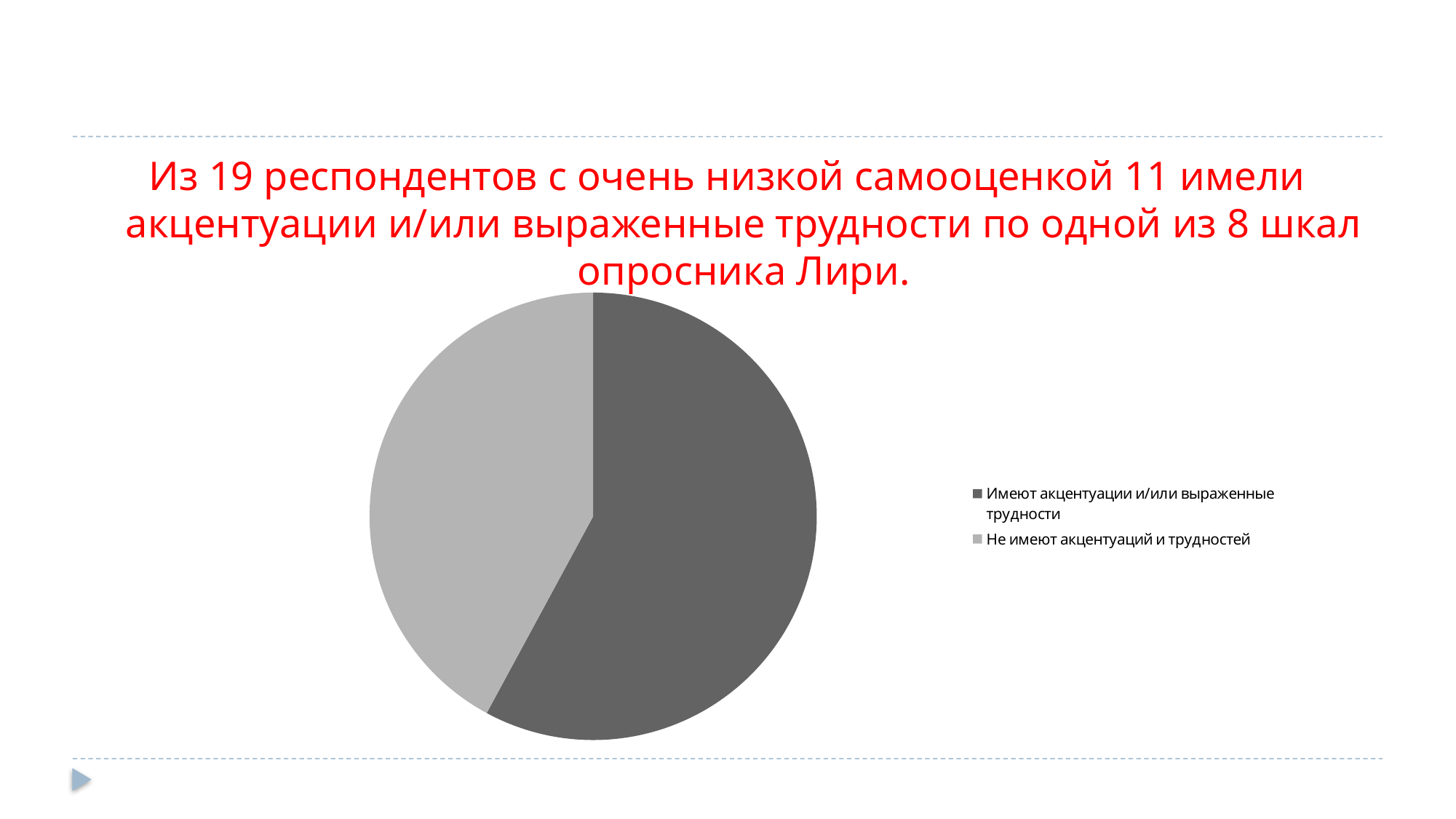
How many slices does the pie chart have? 2 Which slice is the smallest in the pie chart? Не имеют акцентуаций и трудностей Which legend entry is shown in the darker grey colour? Имеют акцентуации и/или выраженные трудности Which slice is the largest in the pie chart? Имеют акцентуации и/или выраженные трудности How many entries does the legend list? 2 Does the slice 'Имеют акцентуации и/или выраженные трудности' take up more or less than half of the pie? more What kind of chart is shown on the slide? pie chart Which slice is larger: 'Имеют акцентуации и/или выраженные трудности' or 'Не имеют акцентуаций и трудностей'? Имеют акцентуации и/или выраженные трудности According to the slide title, how many respondents with very low self-esteem were there in total? 19